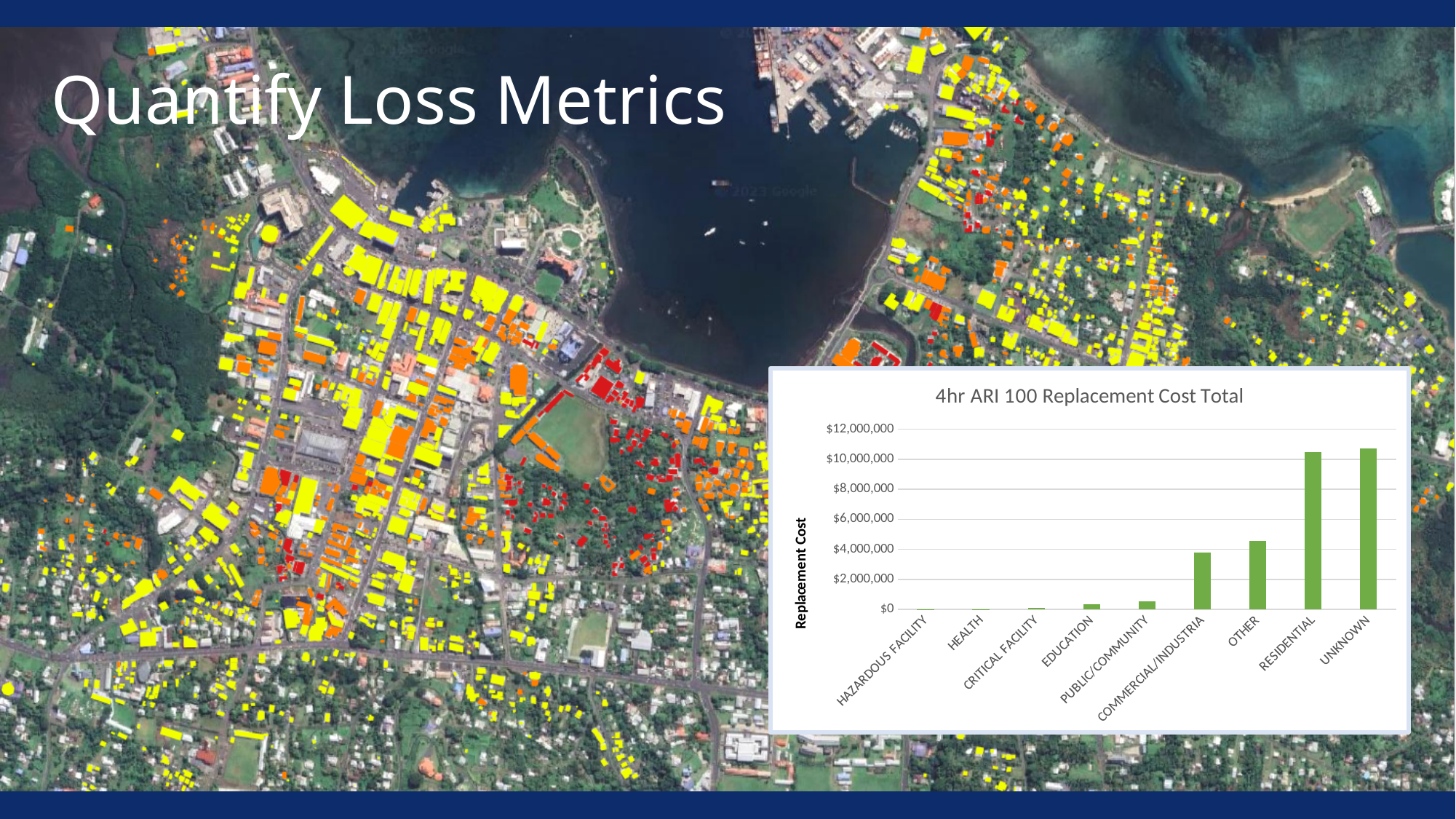
What is the label of the vertical axis of the chart? Replacement Cost Is the value for EDUCATION greater or less than $2,000,000? less What is the title of the chart on the slide? 4hr ARI 100 Replacement Cost Total Is the value for OTHER greater or less than $4,000,000? greater Do the replacement cost values generally rise or fall moving from left to right along the x axis? rise Is the value for COMMERCIAL/INDUSTRIA greater or less than $4,000,000? less Which has a larger replacement cost, OTHER or COMMERCIAL/INDUSTRIA? OTHER Which has a larger replacement cost, RESIDENTIAL or OTHER? RESIDENTIAL What kind of chart is shown on the slide? bar chart How many categories are shown on the x axis of the chart? 9